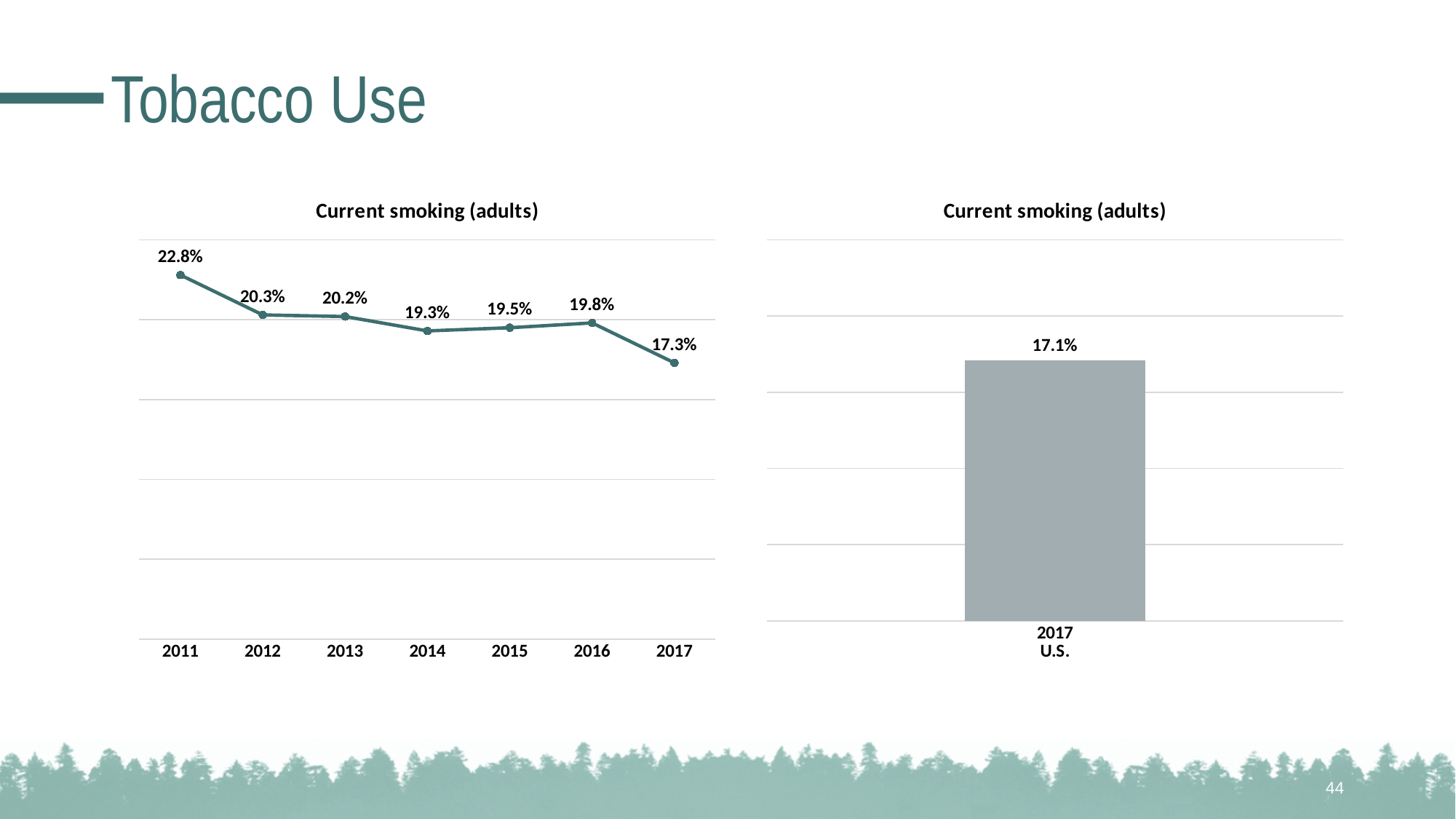
In the left chart, which year has the highest value? 2011 In the right chart, what is the value for 2017 U.S.? 17.1% In the left chart, what is the value for 2017? 17.3% In the left chart, do the values generally rise or fall from 2011 to 2017? fall What kind of chart is the left chart? line chart In the left chart, what is the value for 2014? 19.3% How many years are plotted in the left chart? 7 In the left chart, what is the difference between the 2011 value and the 2017 value? 5.5% In the left chart, what is the value for 2011? 22.8% In the left chart, which is larger, the value for 2012 or the value for 2016? 2012 In the left chart, which year has the lowest value? 2017 What kind of chart is the right chart? bar chart